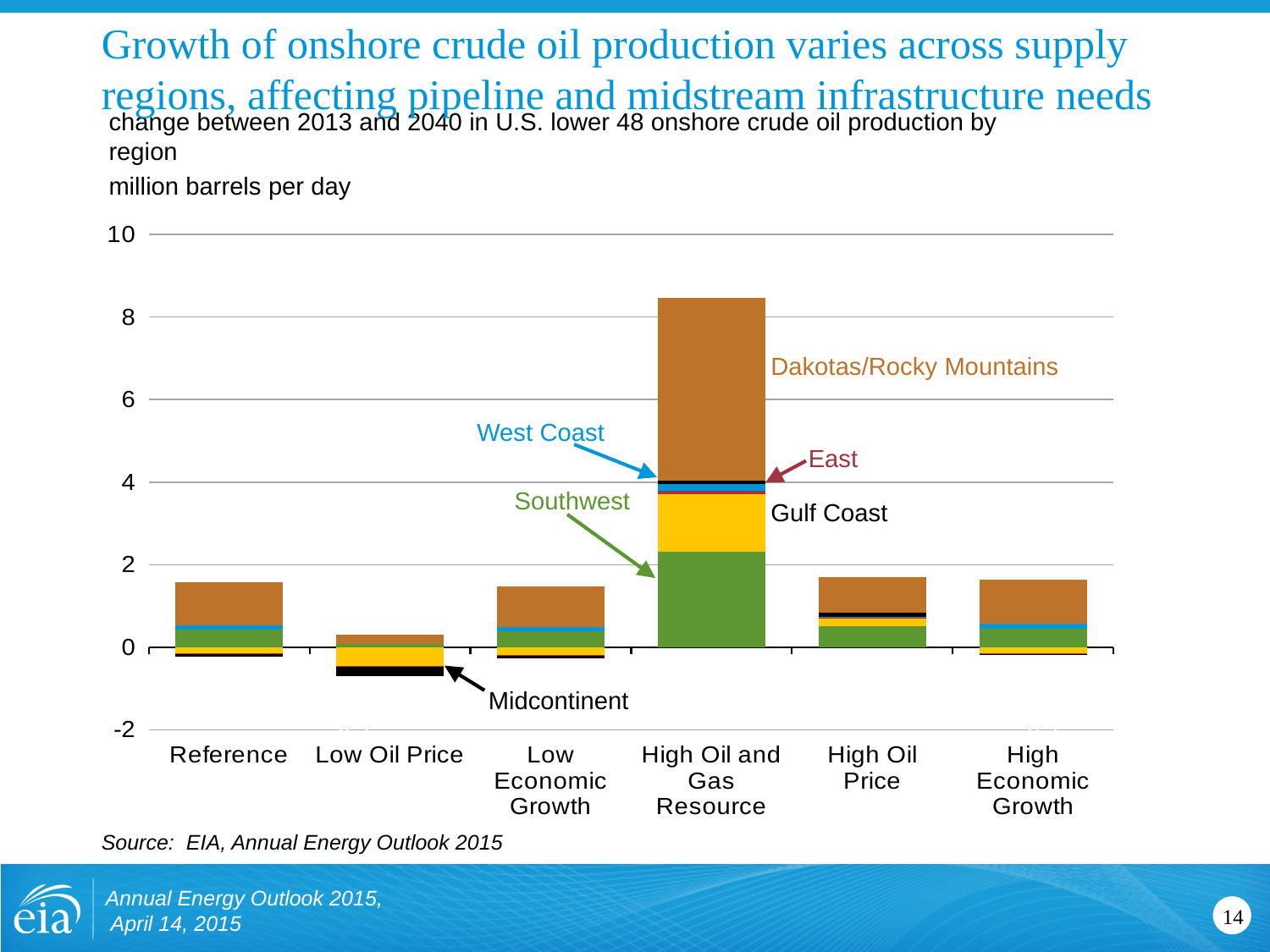
How many scenarios (categories) are shown along the x axis? 6 Which region accounts for the largest segment of the High Oil and Gas Resource bar? Dakotas/Rocky Mountains Is the top of the High Oil and Gas Resource bar greater or less than 8 million barrels per day? greater Which region shows a negative change (below zero) in the Low Oil Price scenario, indicated by the black segment? Midcontinent Which is larger, the total for High Oil and Gas Resource or the total for High Oil Price? High Oil and Gas Resource Is the top of the Low Oil Price bar greater or less than 1 million barrels per day? less How many regions are labeled on the chart? 6 Which scenario has the smallest total change in onshore crude oil production? Low Oil Price What kind of chart is shown on the slide? stacked bar chart Which scenario has the largest total change in onshore crude oil production? High Oil and Gas Resource What unit is used on the y axis of the chart? million barrels per day Is the top of the Reference bar greater or less than 2 million barrels per day? less